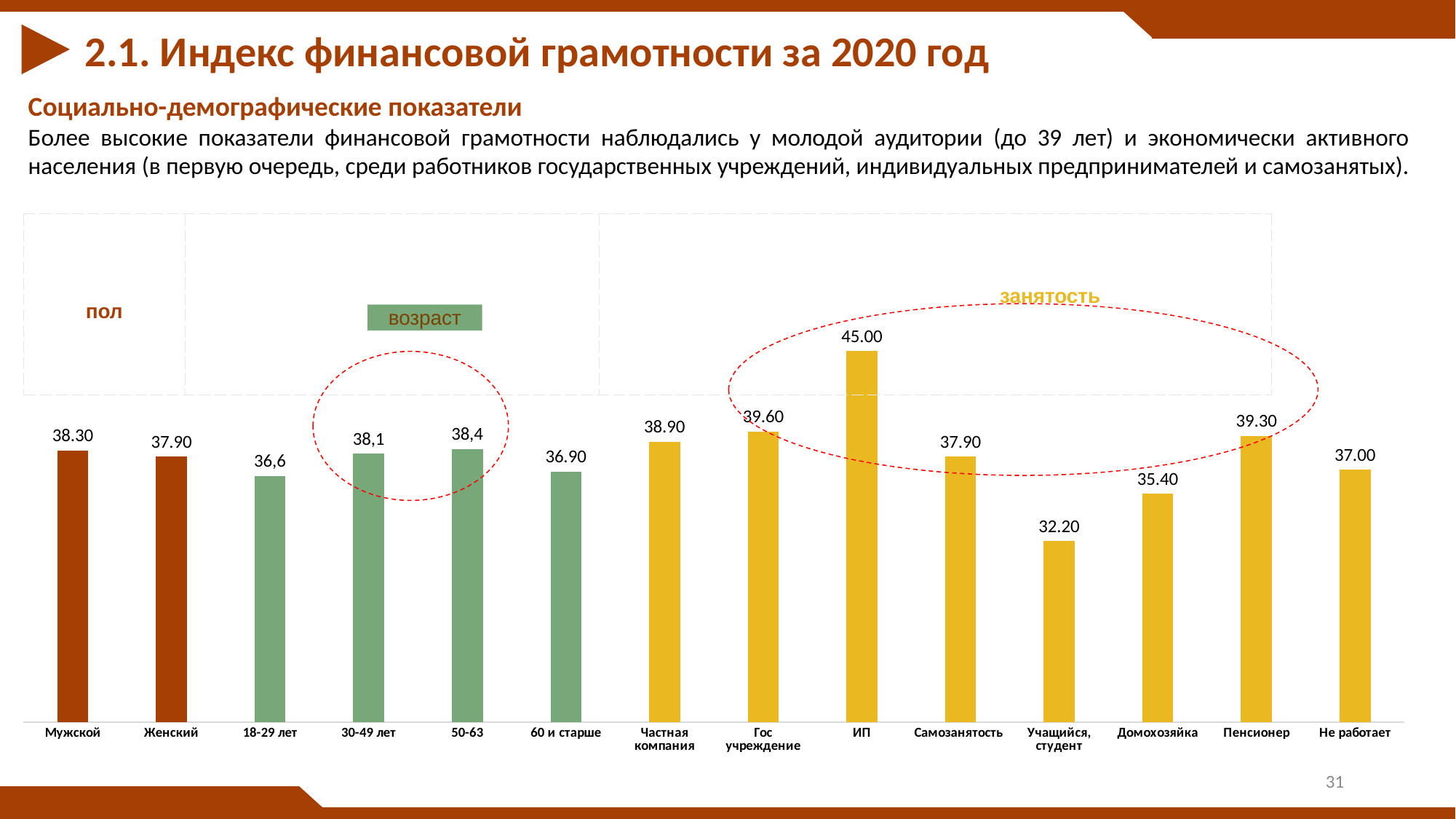
Which category has the lowest value? Учащийся, студент What is the difference between the values for Мужской and Женский? 0.40 What is the value for ИП? 45.00 What kind of chart is shown on the slide? Bar chart What is the value for 30-49 лет? 38,1 How many categories are shown on the chart? 14 What is the difference between the values for ИП and Учащийся, студент? 12.80 What is the value for Учащийся, студент? 32.20 Which category has the highest value? ИП What are the three group labels shown above the bars? пол, возраст, занятость What is the value for Мужской? 38.30 Which is larger, the value for Гос учреждение or the value for Частная компания? Гос учреждение